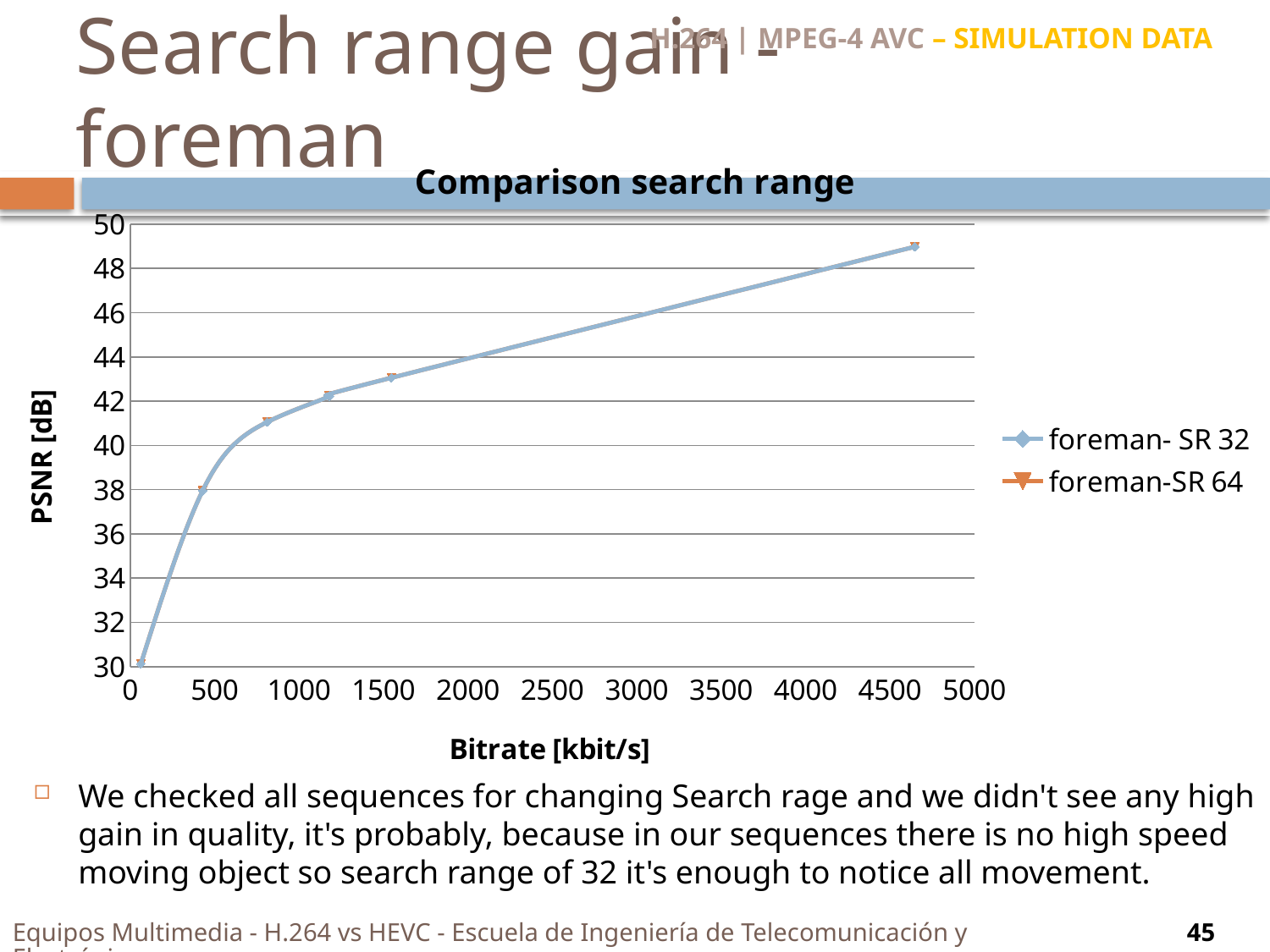
What is the label of the y axis of the chart? PSNR [dB] Does the PSNR value rise or fall as the bitrate increases along the x axis? rise How many data points are plotted for each series in the chart? 6 Is the PSNR value of the lowest-bitrate point (near 0 kbit/s) greater or less than 32? less Is the PSNR value of the point near 1500 kbit/s greater or less than 42? greater How many series does the legend of the chart list? 2 Is the PSNR value of the point near 500 kbit/s greater or less than 40? less Which point has the highest PSNR value: the one near 1000 kbit/s or the one near 4500 kbit/s? the one near 4500 kbit/s What kind of chart is shown on the slide? line chart What is the title of the chart? Comparison search range